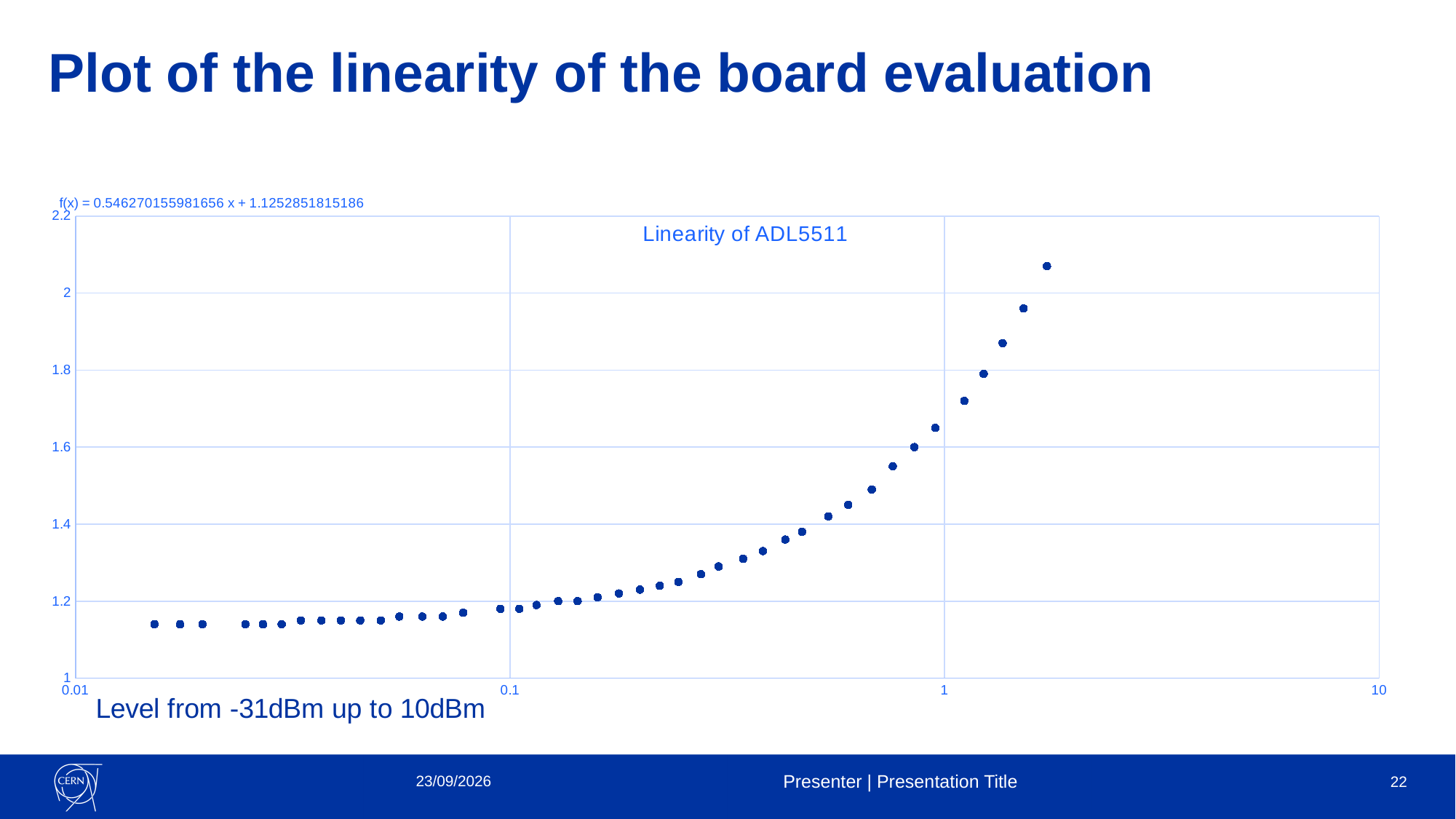
Is the plotted value at x = 1 greater or less than 1.4? greater Is the value of the highest plotted point greater or less than 2? greater Do the plotted values rise or fall as the x-axis value increases? rise What kind of chart is shown on the slide? scatter chart Which plotted point has the higher value, the leftmost point or the rightmost point? the rightmost point What is the title of the chart? Linearity of ADL5511 What trendline equation is printed above the chart? f(x) = 0.546270155981656 x + 1.1252851815186 Is the rightmost plotted point greater or less than 1.8? greater